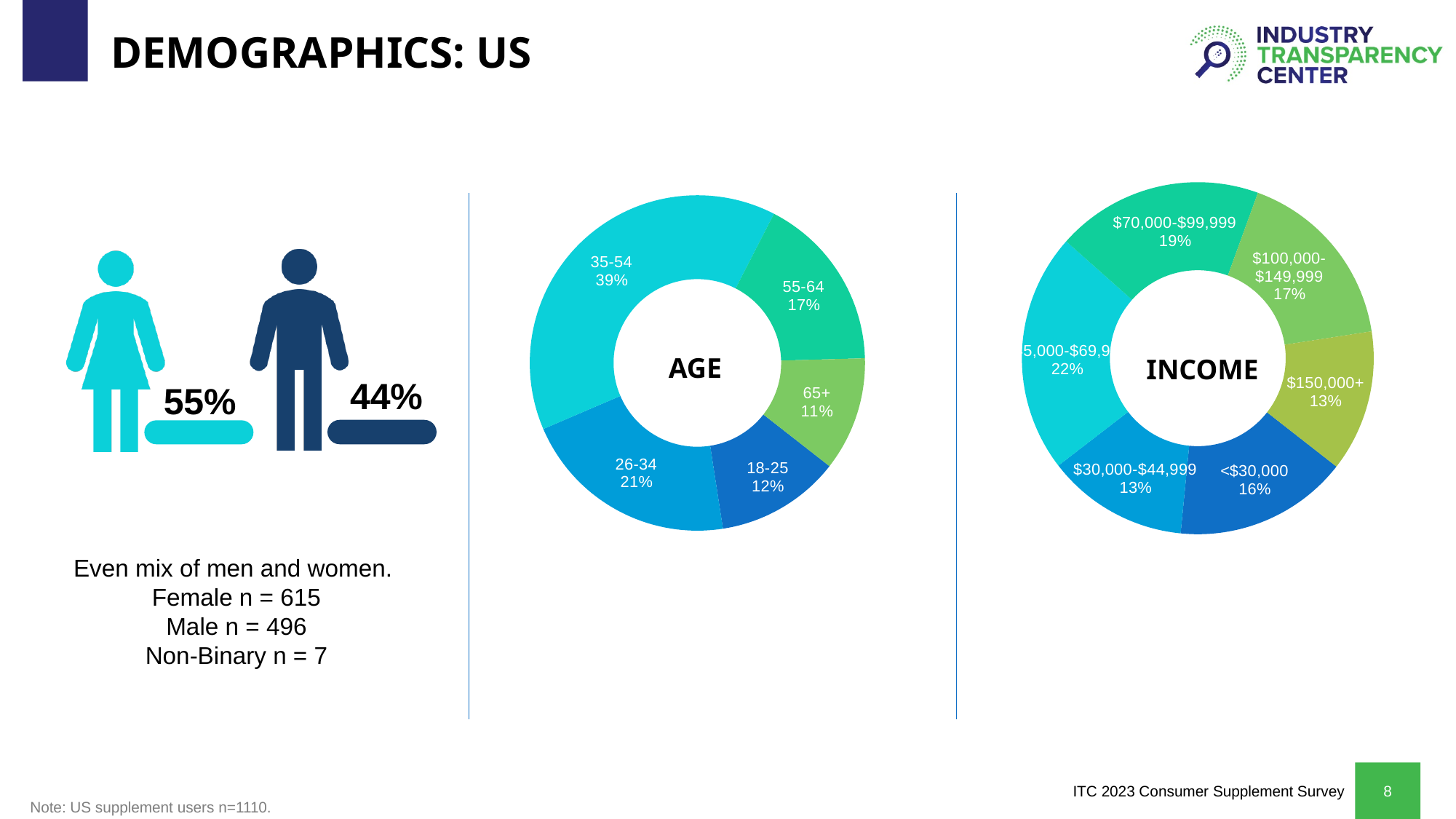
How many income bands are shown in the INCOME chart? 6 In the AGE chart, what share of respondents are aged 35-54? 39% In the INCOME chart, what share of respondents earn $70,000-$99,999? 19% How many age groups are shown in the AGE chart? 5 What type of chart is the AGE chart? Donut chart In the AGE chart, what is the difference in percentage points between the 35-54 and 55-64 groups? 22 In the INCOME chart, which is larger: the share earning $100,000-$149,999 or the share earning $150,000+? $100,000-$149,999 What is the title shown in the centre of the right-hand donut chart? INCOME In the INCOME chart, what share of respondents earn less than $30,000? 16% In the AGE chart, what share of respondents are aged 26-34? 21% In the AGE chart, which age group has the smallest share? 65+ In the AGE chart, which age group has the largest share? 35-54